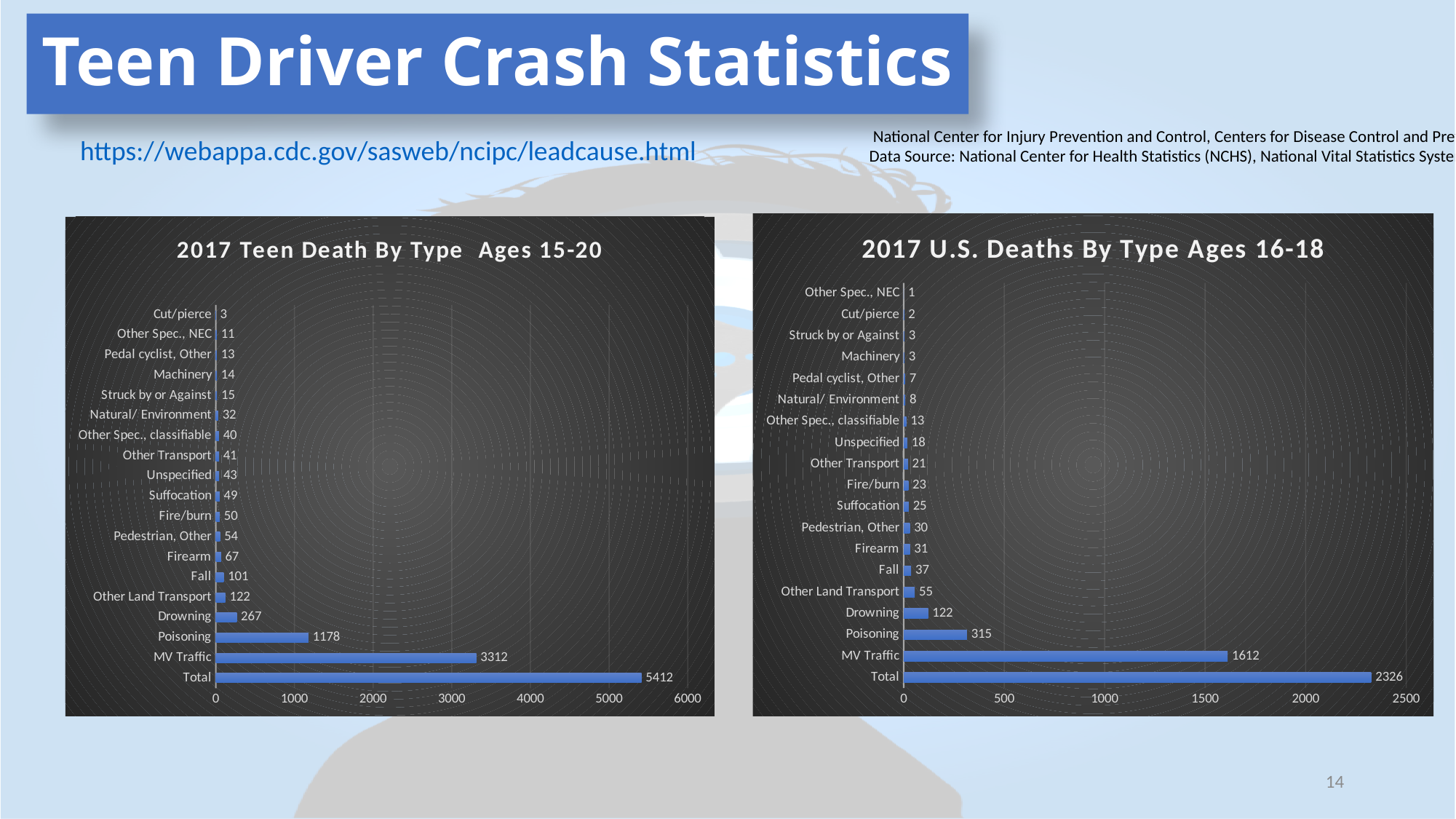
In the '2017 Teen Death By Type Ages 15-20' chart, what is the value for Drowning? 267 In the '2017 Teen Death By Type Ages 15-20' chart, what is the value for MV Traffic? 3312 In the '2017 U.S. Deaths By Type Ages 16-18' chart, what is the value for Poisoning? 315 In the '2017 Teen Death By Type Ages 15-20' chart, what is the difference between MV Traffic and Poisoning? 2134 In the '2017 U.S. Deaths By Type Ages 16-18' chart, what is the difference between Total and MV Traffic? 714 How many categories are shown in the '2017 U.S. Deaths By Type Ages 16-18' chart? 19 What kind of chart is the '2017 Teen Death By Type Ages 15-20' chart? Bar chart In the '2017 U.S. Deaths By Type Ages 16-18' chart, what is the value for Firearm? 31 In the '2017 Teen Death By Type Ages 15-20' chart, which category other than Total has the highest value? MV Traffic In the '2017 U.S. Deaths By Type Ages 16-18' chart, is the value for MV Traffic greater or less than 1500? greater In the '2017 U.S. Deaths By Type Ages 16-18' chart, which category has the lowest value? Other Spec., NEC In the '2017 Teen Death By Type Ages 15-20' chart, which is larger, Fall or Firearm? Fall